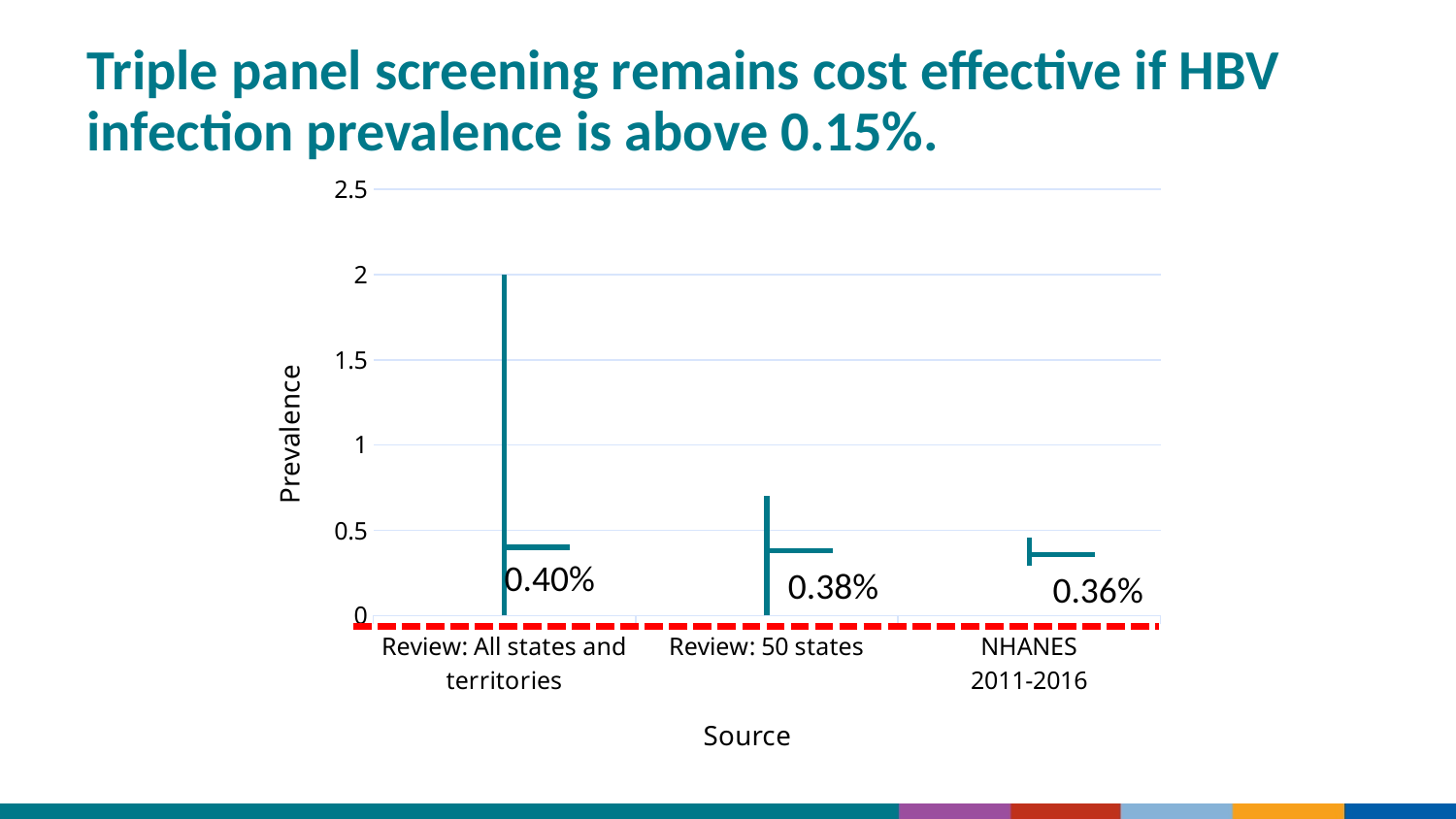
How many sources are shown on the x axis of the chart? 3 What is the difference between the labelled prevalence for Review: All states and territories and for NHANES 2011-2016? 0.04% Which source has the highest labelled prevalence value? Review: All states and territories Which source has the lowest labelled prevalence value? NHANES 2011-2016 What is the prevalence value shown for Review: 50 states? 0.38% What is the label on the y axis of the chart? Prevalence Which has a larger labelled prevalence value, Review: 50 states or NHANES 2011-2016? Review: 50 states What is the prevalence value shown for Review: All states and territories? 0.40% Is the labelled prevalence value for Review: 50 states greater or less than 0.5? less What is the label on the x axis of the chart? Source What is the prevalence value shown for NHANES 2011-2016? 0.36% Do the labelled prevalence values rise or fall from left to right along the x axis? fall